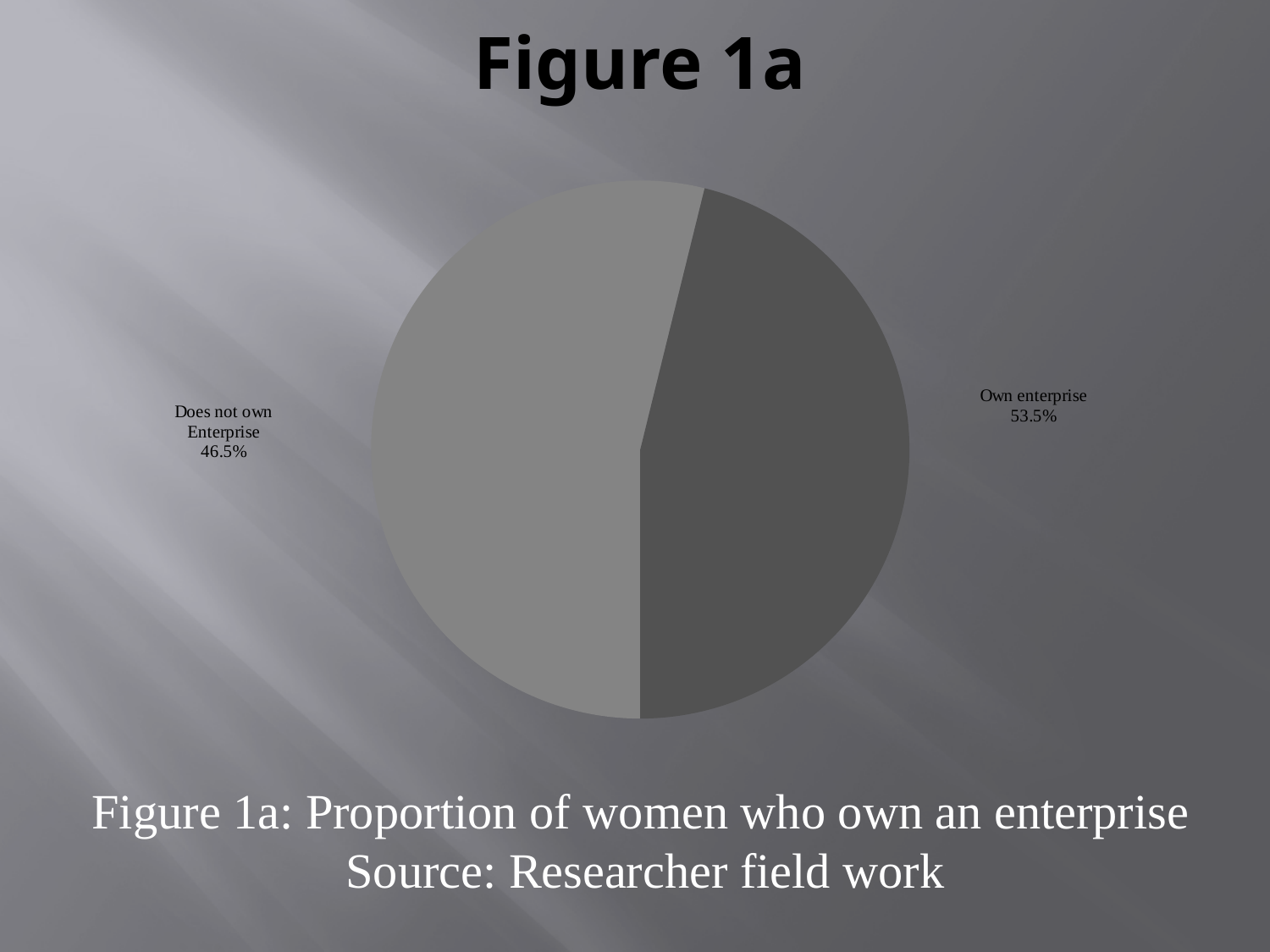
What kind of chart is shown on the slide? pie chart Which slice of the pie is the largest? Own enterprise What percentage of women do not own an enterprise? 46.5% Is the share of women who own an enterprise greater or less than 50%? greater What is the caption given for the chart below the pie? Figure 1a: Proportion of women who own an enterprise What percentage of women own an enterprise? 53.5% Which is larger: the share of women who own an enterprise or the share who do not? Own enterprise What is the difference in percentage points between the 'Own enterprise' and 'Does not own Enterprise' slices? 7 percentage points What source is cited for the chart data? Researcher field work Which slice of the pie is the smallest? Does not own Enterprise How many slices does the pie chart have? 2